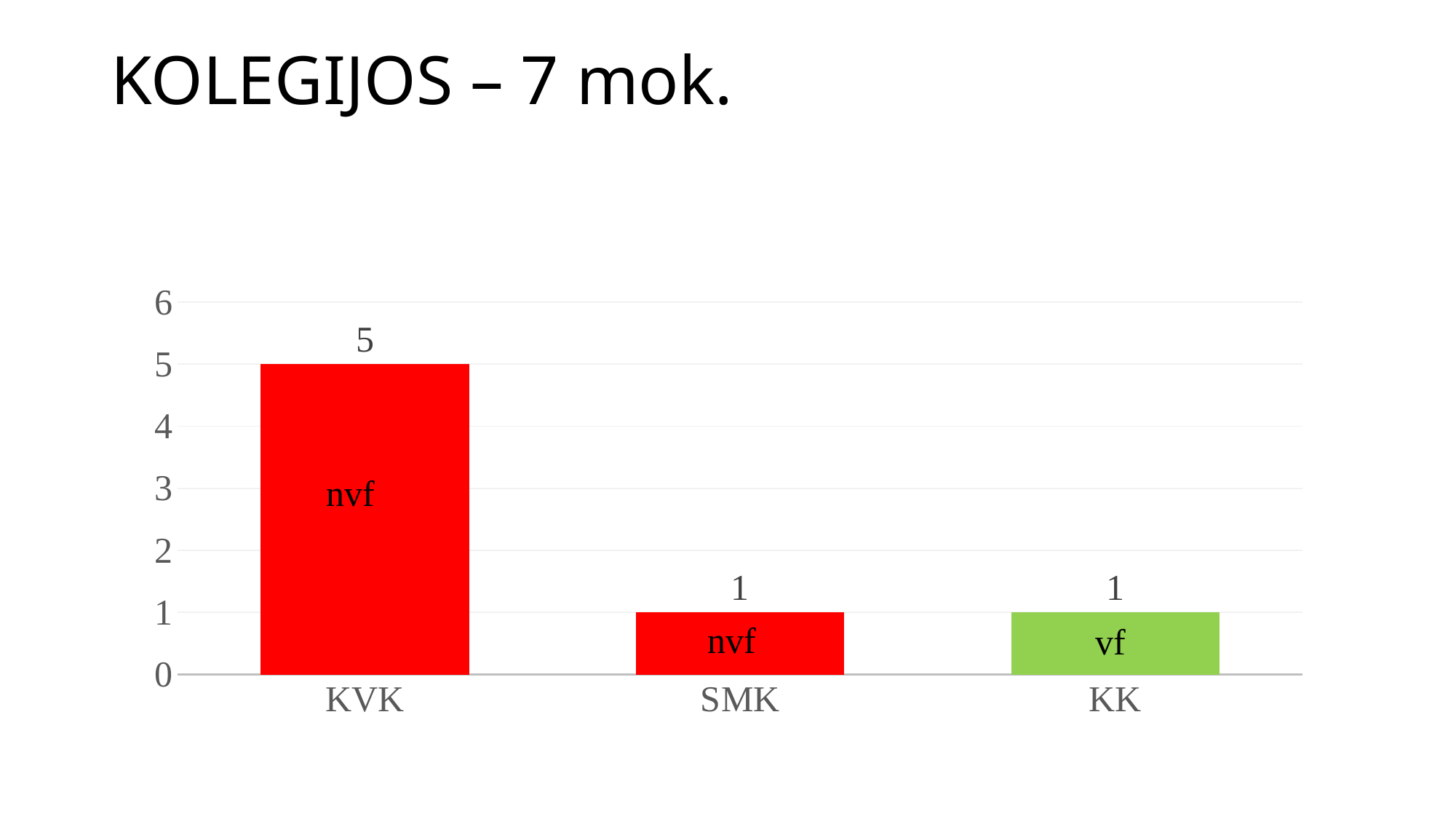
What is the difference between the values for KVK and SMK? 4 How many categories are shown on the x axis? 3 Is the value for KVK greater or less than 4? greater What is the value for SMK? 1 What is the total of the values for KVK, SMK and KK? 7 Which is larger, the value for KVK or the value for KK? KVK What label is written inside the KK bar? vf What colour is the KK bar? green What kind of chart is shown on the slide? bar chart What is the value for KK? 1 Which category has the highest value? KVK What is the value for KVK? 5